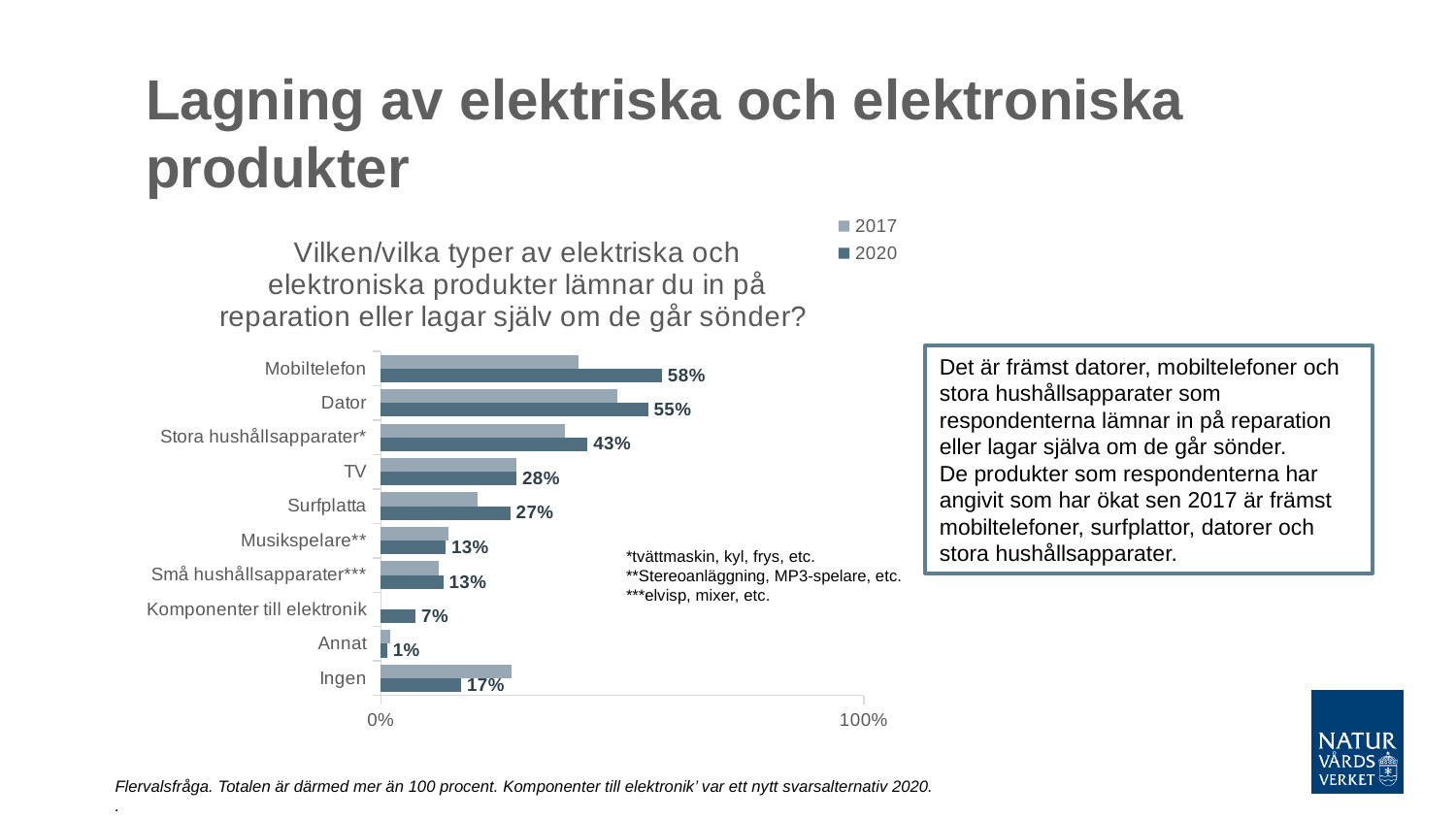
What is the difference between the 2020 values for Mobiltelefon and Dator? 3% How many categories are shown on the chart? 10 What is the 2020 value for Stora hushållsapparater*? 43% Which has a larger 2020 value, TV or Komponenter till elektronik? TV What kind of chart is shown on the slide? Bar chart Which category has the lowest 2020 value? Annat Which years are listed in the chart legend? 2017 and 2020 What is the 2020 value for Ingen? 17% What is the 2020 value for Mobiltelefon? 58% Which category has the highest 2020 value? Mobiltelefon How many series does the legend list? 2 What is the 2020 value for Surfplatta? 27%